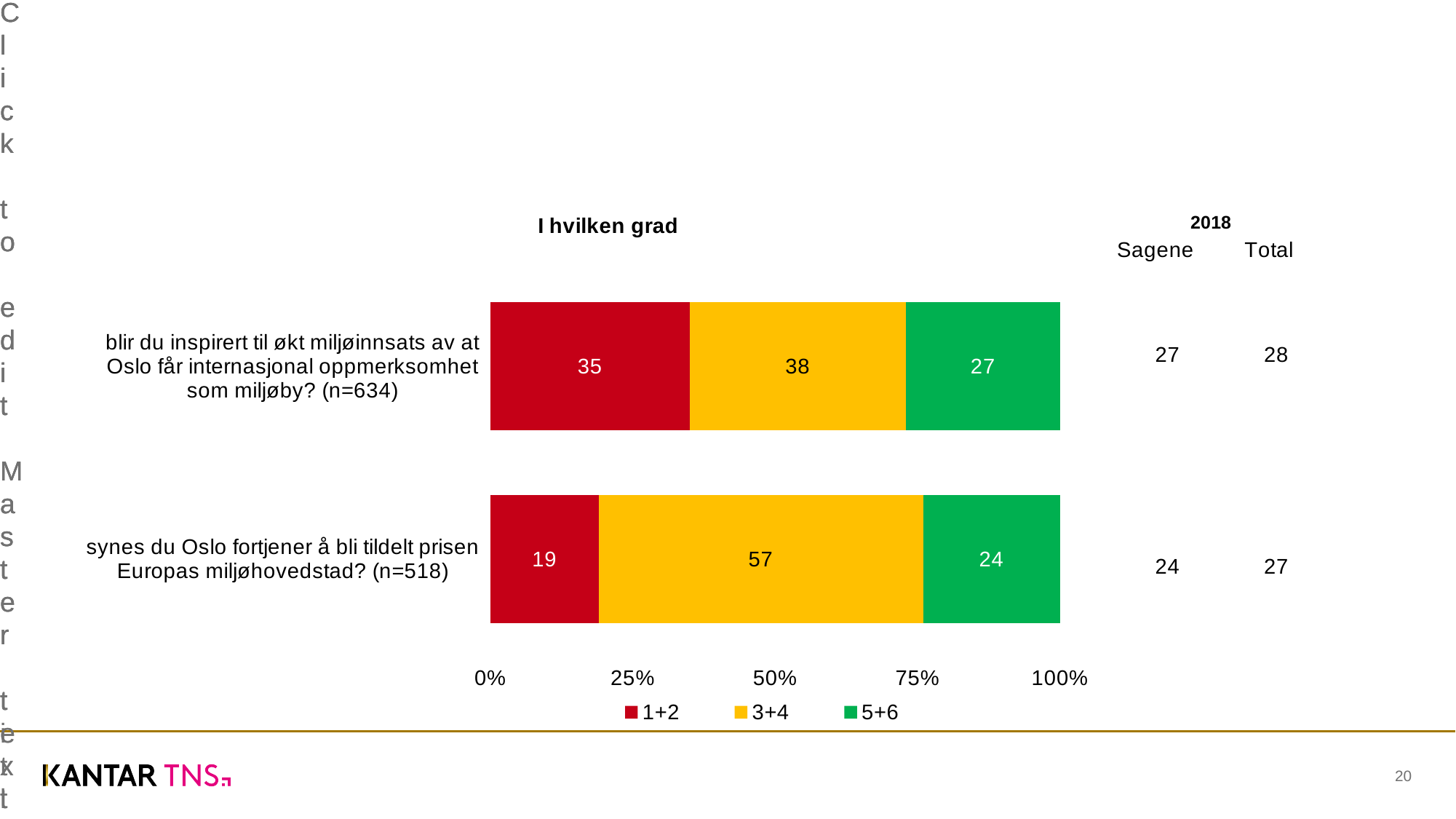
What kind of chart is shown on the slide? stacked bar chart What is the value of the 5+6 segment for "synes du Oslo fortjener å bli tildelt prisen Europas miljøhovedstad? (n=518)"? 24 What is the title of the chart? I hvilken grad What is the value of the 1+2 segment for "blir du inspirert til økt miljøinnsats av at Oslo får internasjonal oppmerksomhet som miljøby? (n=634)"? 35 What is the total of the stacked bar for "blir du inspirert til økt miljøinnsats av at Oslo får internasjonal oppmerksomhet som miljøby? (n=634)"? 100 How many question categories are plotted in the chart? 2 Is the 1+2 value larger for "blir du inspirert til økt miljøinnsats..." or for "synes du Oslo fortjener å bli tildelt prisen..."? blir du inspirert til økt miljøinnsats av at Oslo får internasjonal oppmerksomhet som miljøby? (n=634) What is the difference between the 3+4 values of the two categories? 19 Which category has the smaller 1+2 segment? synes du Oslo fortjener å bli tildelt prisen Europas miljøhovedstad? (n=518) Which category has the larger 3+4 segment? synes du Oslo fortjener å bli tildelt prisen Europas miljøhovedstad? (n=518) How many series does the legend list? 3 What is the value of the 3+4 segment for "synes du Oslo fortjener å bli tildelt prisen Europas miljøhovedstad? (n=518)"? 57